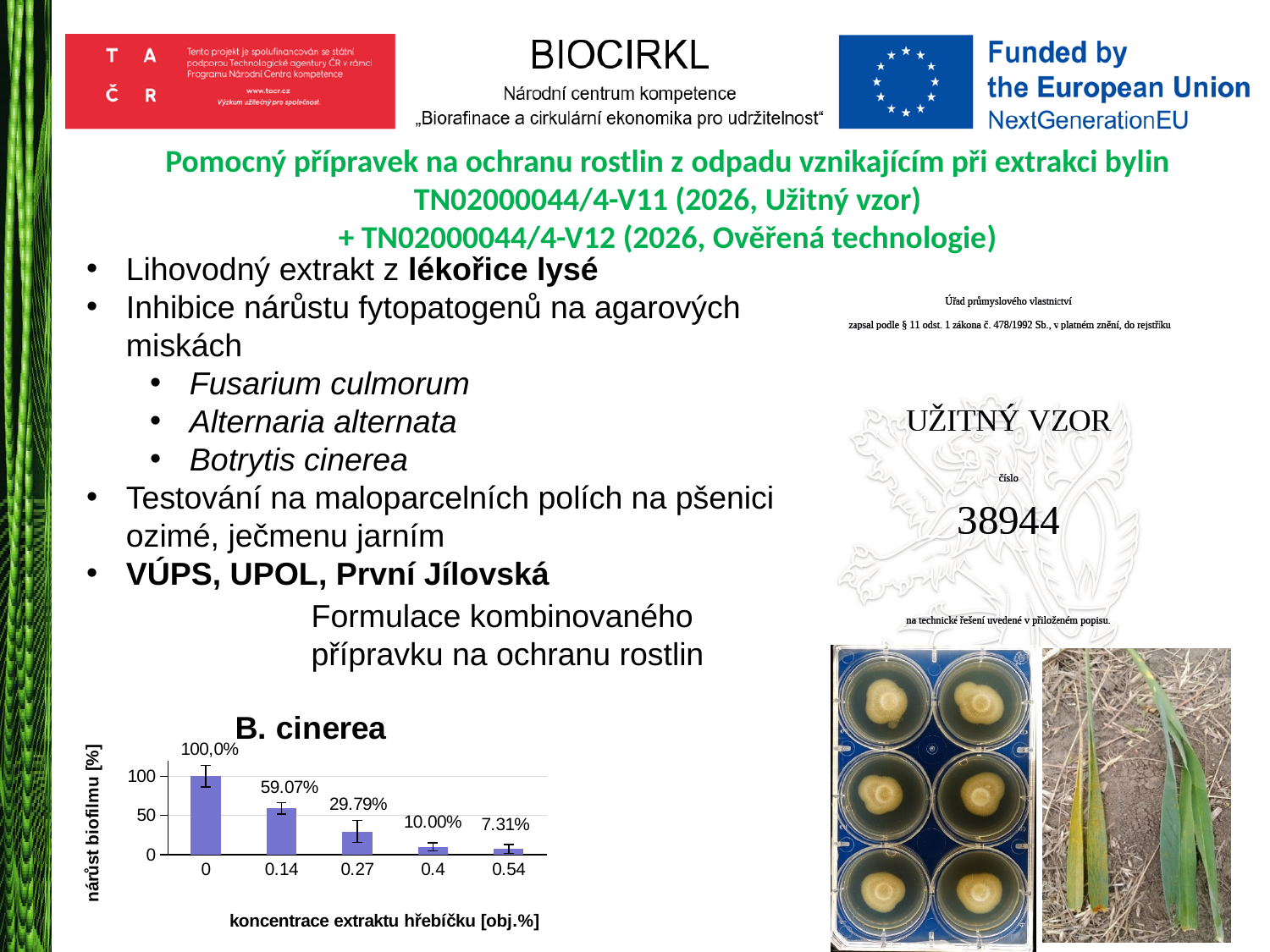
In the B. cinerea chart, what is the biofilm growth value at a clove extract concentration of 0.14 obj.%? 59.07% Which concentration in the B. cinerea chart has the highest biofilm growth? 0 In the B. cinerea chart, what is the biofilm growth value at a concentration of 0.54 obj.%? 7.31% In the B. cinerea chart, what is the difference in biofilm growth between concentrations 0.14 and 0.27 obj.%? 29.28% How many concentration categories are plotted on the x axis of the B. cinerea chart? 5 What is the title of the chart on the slide? B. cinerea In the B. cinerea chart, what is the biofilm growth value at a concentration of 0.4 obj.%? 10.00% In the B. cinerea chart, is the biofilm growth higher at concentration 0.4 or at 0.54 obj.%? 0.4 In the B. cinerea chart, does biofilm growth rise or fall as the clove extract concentration increases along the x axis? fall Which concentration in the B. cinerea chart has the lowest biofilm growth? 0.54 In the B. cinerea chart, what is the biofilm growth value at a concentration of 0.27 obj.%? 29.79% What type of chart is shown on the slide? bar chart